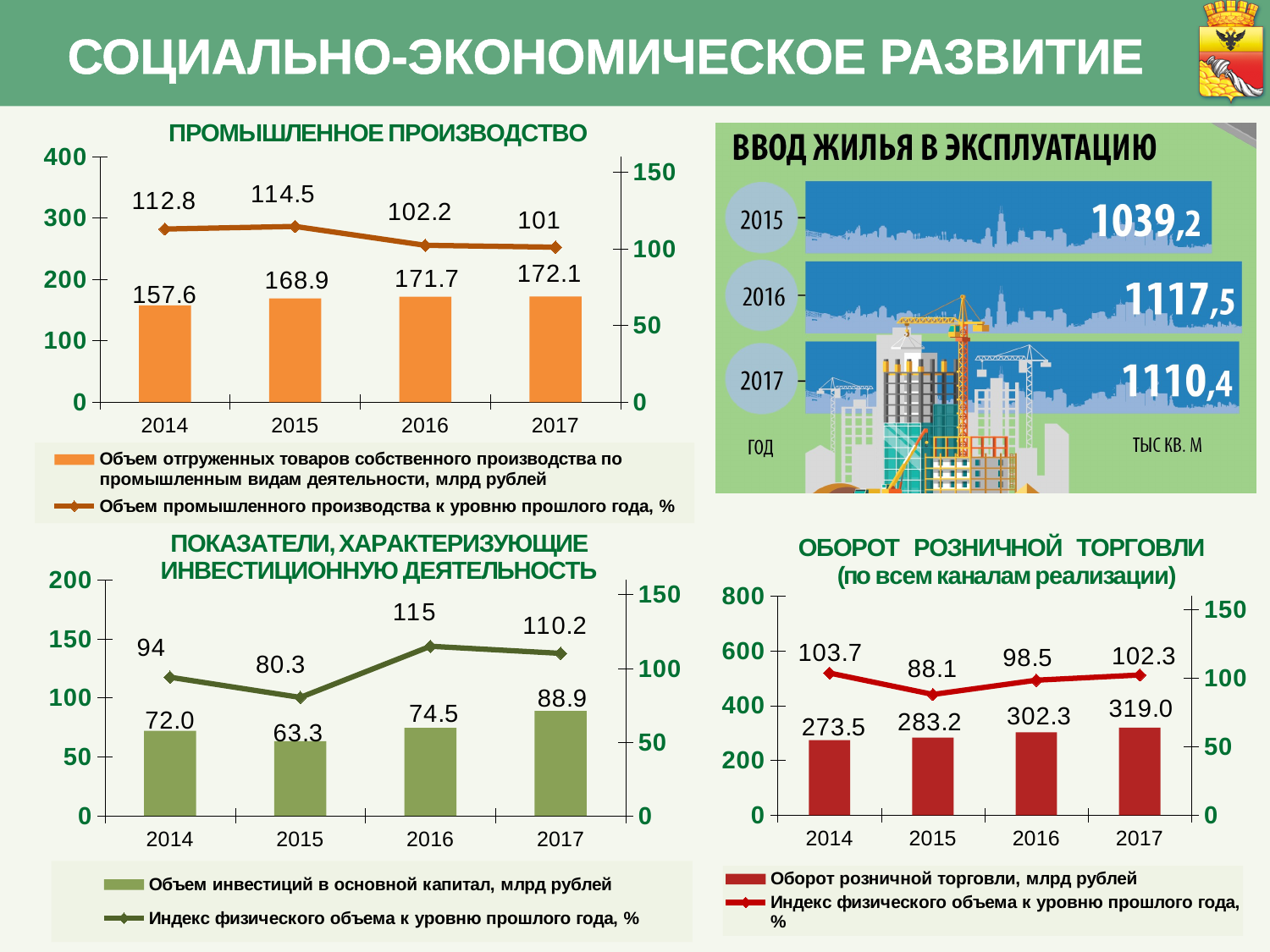
In the chart titled «ПОКАЗАТЕЛИ, ХАРАКТЕРИЗУЮЩИЕ ИНВЕСТИЦИОННУЮ ДЕЯТЕЛЬНОСТЬ», how many series does the legend list? 2 In the chart titled «ПОКАЗАТЕЛИ, ХАРАКТЕРИЗУЮЩИЕ ИНВЕСТИЦИОННУЮ ДЕЯТЕЛЬНОСТЬ», what is the difference between the «Индекс физического объема к уровню прошлого года, %» values for 2016 and 2015? 34.7 In the chart titled «ПРОМЫШЛЕННОЕ ПРОИЗВОДСТВО», what is the value of «Объем отгруженных товаров собственного производства по промышленным видам деятельности, млрд рублей» for 2015? 168.9 In the chart titled «ПОКАЗАТЕЛИ, ХАРАКТЕРИЗУЮЩИЕ ИНВЕСТИЦИОННУЮ ДЕЯТЕЛЬНОСТЬ», what is the value of «Объем инвестиций в основной капитал, млрд рублей» for 2017? 88.9 In the chart titled «ОБОРОТ РОЗНИЧНОЙ ТОРГОВЛИ», which is larger: the «Индекс физического объема к уровню прошлого года, %» value for 2014 or for 2017? 2014 In the chart titled «ПРОМЫШЛЕННОЕ ПРОИЗВОДСТВО», does the bar series rise or fall from 2014 to 2017? rise What kind of chart is the one titled «ОБОРОТ РОЗНИЧНОЙ ТОРГОВЛИ»? Combined bar and line chart In the chart titled «ОБОРОТ РОЗНИЧНОЙ ТОРГОВЛИ», how many years are shown on the x axis? 4 In the chart titled «ОБОРОТ РОЗНИЧНОЙ ТОРГОВЛИ», what is the value of «Оборот розничной торговли, млрд рублей» for 2016? 302.3 In the chart titled «ПРОМЫШЛЕННОЕ ПРОИЗВОДСТВО», what is the value of «Объем промышленного производства к уровню прошлого года, %» for 2017? 101 In the chart titled «ПОКАЗАТЕЛИ, ХАРАКТЕРИЗУЮЩИЕ ИНВЕСТИЦИОННУЮ ДЕЯТЕЛЬНОСТЬ», which year has the lowest value of «Объем инвестиций в основной капитал, млрд рублей»? 2015 In the chart titled «ПРОМЫШЛЕННОЕ ПРОИЗВОДСТВО», which year has the highest value of «Объем промышленного производства к уровню прошлого года, %»? 2015